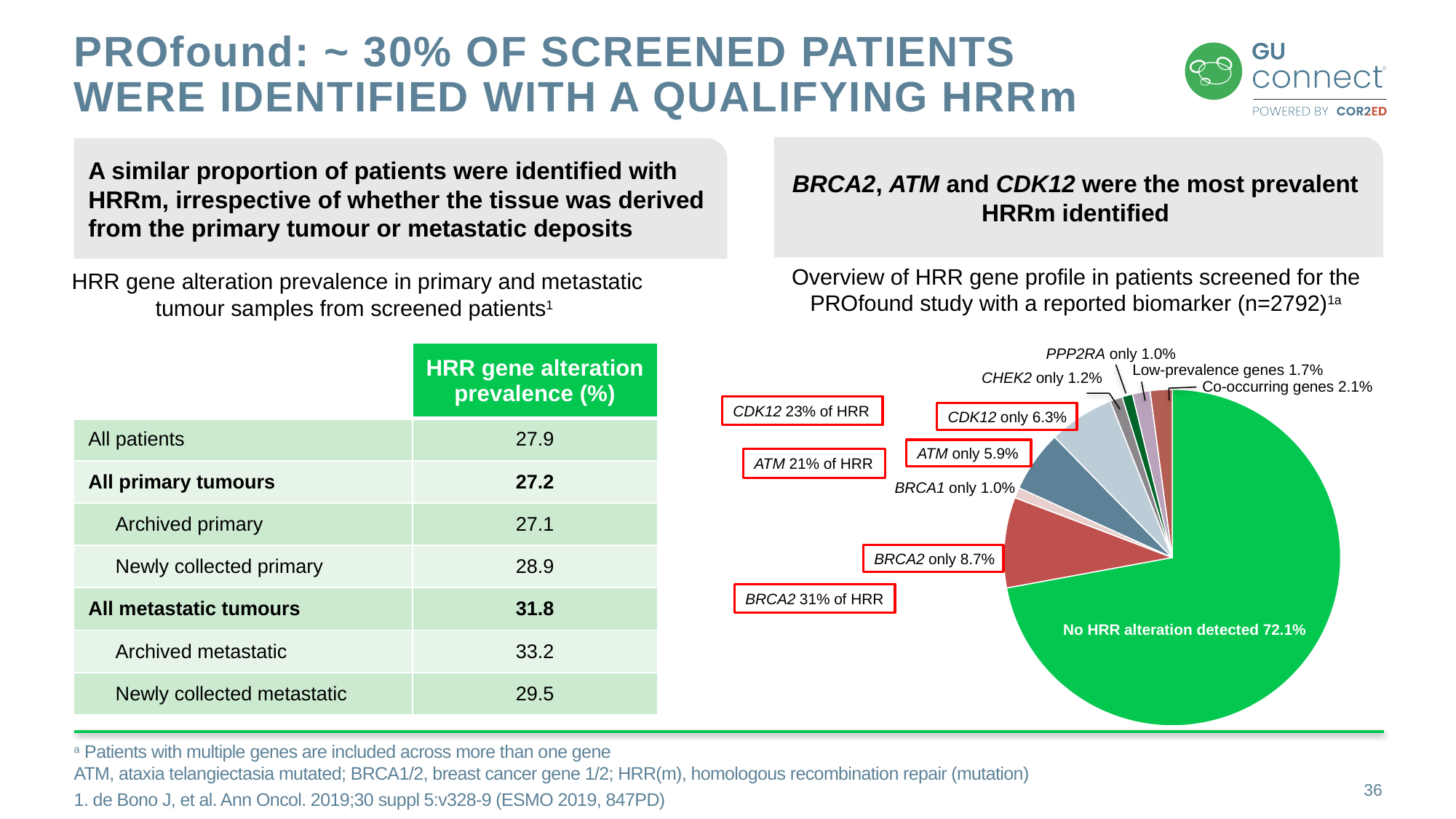
In the pie chart, what is the difference between 'BRCA2 only' and 'ATM only'? 2.8 percentage points What kind of chart is used to show the overview of HRR gene profile in patients screened for the PROfound study? Pie chart In the pie chart, what is the percentage for 'CDK12 only'? 6.3% In the pie chart, which is larger: 'CDK12 only' or 'ATM only'? CDK12 only How many slices does the pie chart have? 9 In the pie chart, what is the percentage for 'CHEK2 only'? 1.2% In the pie chart, what is the percentage for 'BRCA2 only'? 8.7% Which slice of the pie chart is the largest? No HRR alteration detected According to the callout on the pie chart, what share of HRR alterations does BRCA2 account for? 31% of HRR In the pie chart, what is the percentage for 'Co-occurring genes'? 2.1% In the pie chart, what percentage of patients had no HRR alteration detected? 72.1% In the pie chart, what is the percentage for 'ATM only'? 5.9%